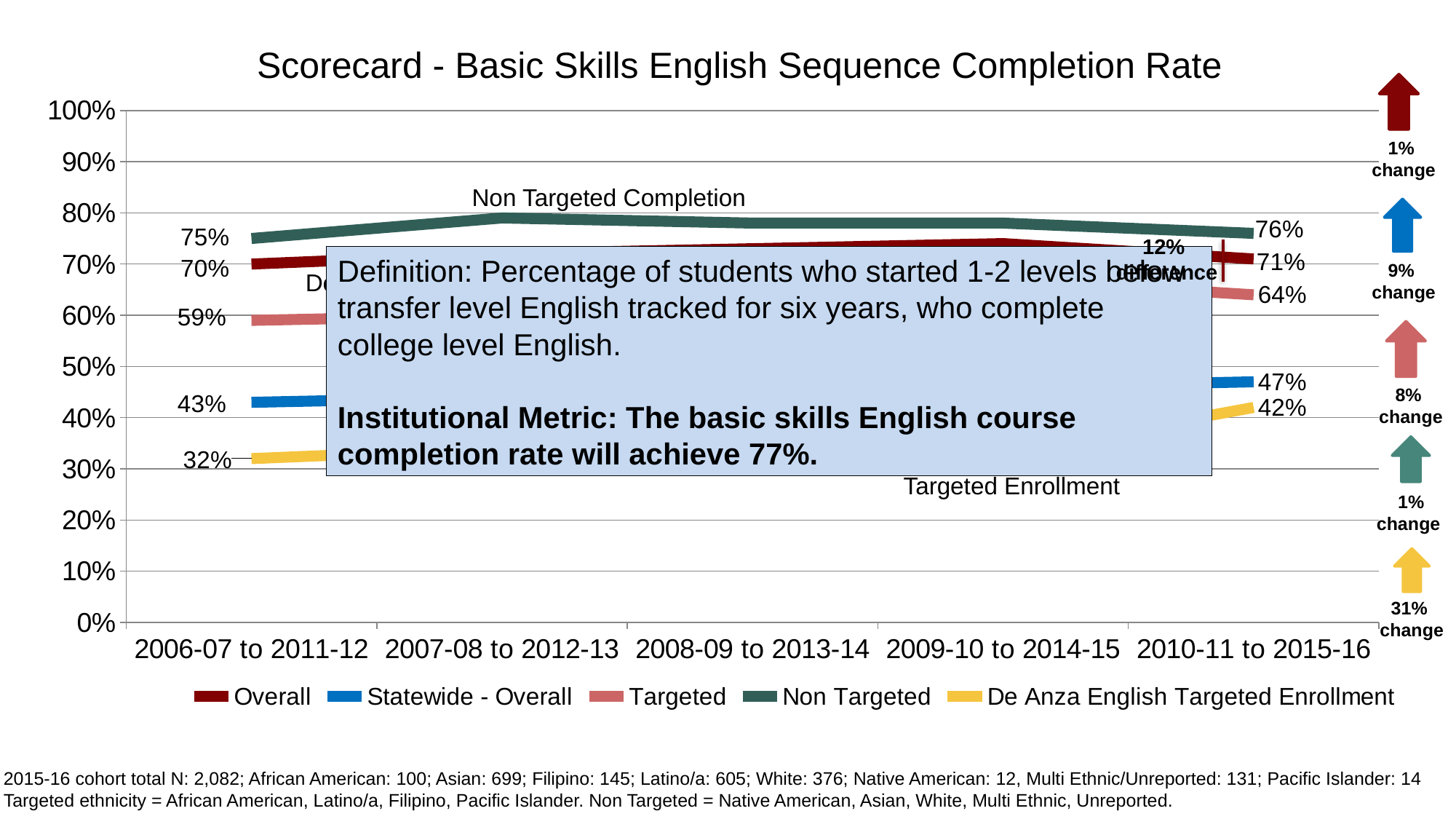
Does the De Anza English Targeted Enrollment series rise or fall from the first cohort to the last cohort? rise What is the title of the chart? Scorecard - Basic Skills English Sequence Completion Rate What kind of chart is shown on the slide? line chart What is the Non Targeted completion rate for the 2006-07 to 2011-12 cohort? 75% What is the De Anza English Targeted Enrollment value for the 2006-07 to 2011-12 cohort? 32% What is the difference between the Targeted completion rate in 2010-11 to 2015-16 and in 2006-07 to 2011-12? 5% What is the Overall completion rate for the 2010-11 to 2015-16 cohort? 71% What is the Statewide - Overall completion rate for the 2010-11 to 2015-16 cohort? 47% How many cohort periods are shown on the x axis? 5 Which series has the highest value for the 2010-11 to 2015-16 cohort? Non Targeted Which series has the lowest value for the 2006-07 to 2011-12 cohort? De Anza English Targeted Enrollment How many series does the legend list? 5